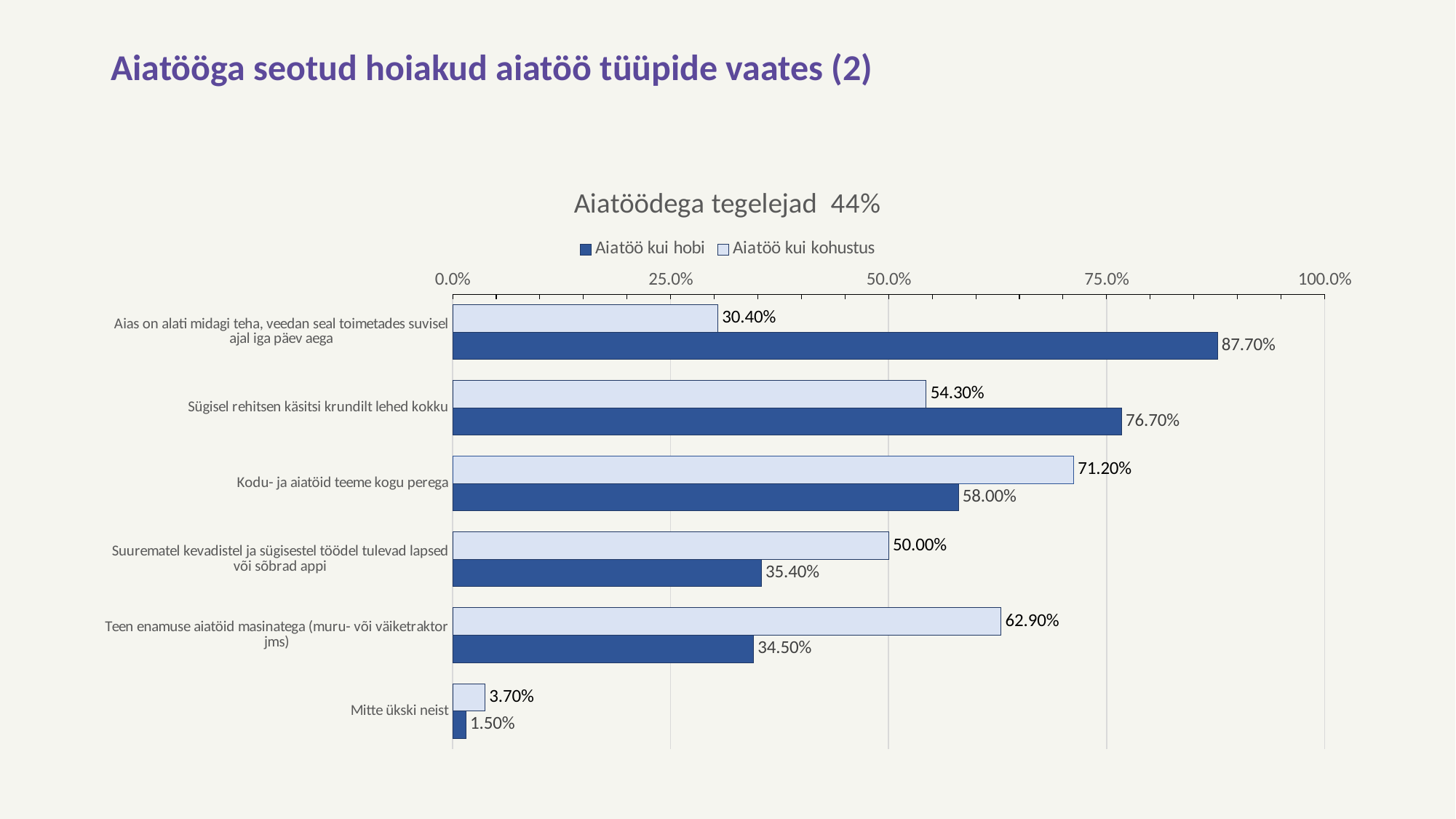
Which category has the lowest value for the "Aiatöö kui kohustus" series? Mitte ükski neist How many series does the legend list? 2 What is the title of the chart? Aiatöödega tegelejad 44% For "Teen enamuse aiatöid masinatega (muru- või väiketraktor jms)", which series has the larger value, "Aiatöö kui hobi" or "Aiatöö kui kohustus"? Aiatöö kui kohustus Is the "Aiatöö kui hobi" value for "Suurematel kevadistel ja sügisestel töödel tulevad lapsed või sõbrad appi" greater or less than 50.0%? less What is the value for "Aiatöö kui kohustus" for the category "Kodu- ja aiatöid teeme kogu perega"? 71.20% How many categories are shown on the chart? 6 What is the value for "Aiatöö kui hobi" for the category "Aias on alati midagi teha, veedan seal toimetades suvisel ajal iga päev aega"? 87.70% Which category has the highest value for the "Aiatöö kui hobi" series? Aias on alati midagi teha, veedan seal toimetades suvisel ajal iga päev aega What is the difference between the "Aiatöö kui hobi" and "Aiatöö kui kohustus" values for "Sügisel rehitsen käsitsi krundilt lehed kokku"? 22.40% What kind of chart is shown on the slide? bar chart What is the value for "Aiatöö kui hobi" for the category "Mitte ükski neist"? 1.50%